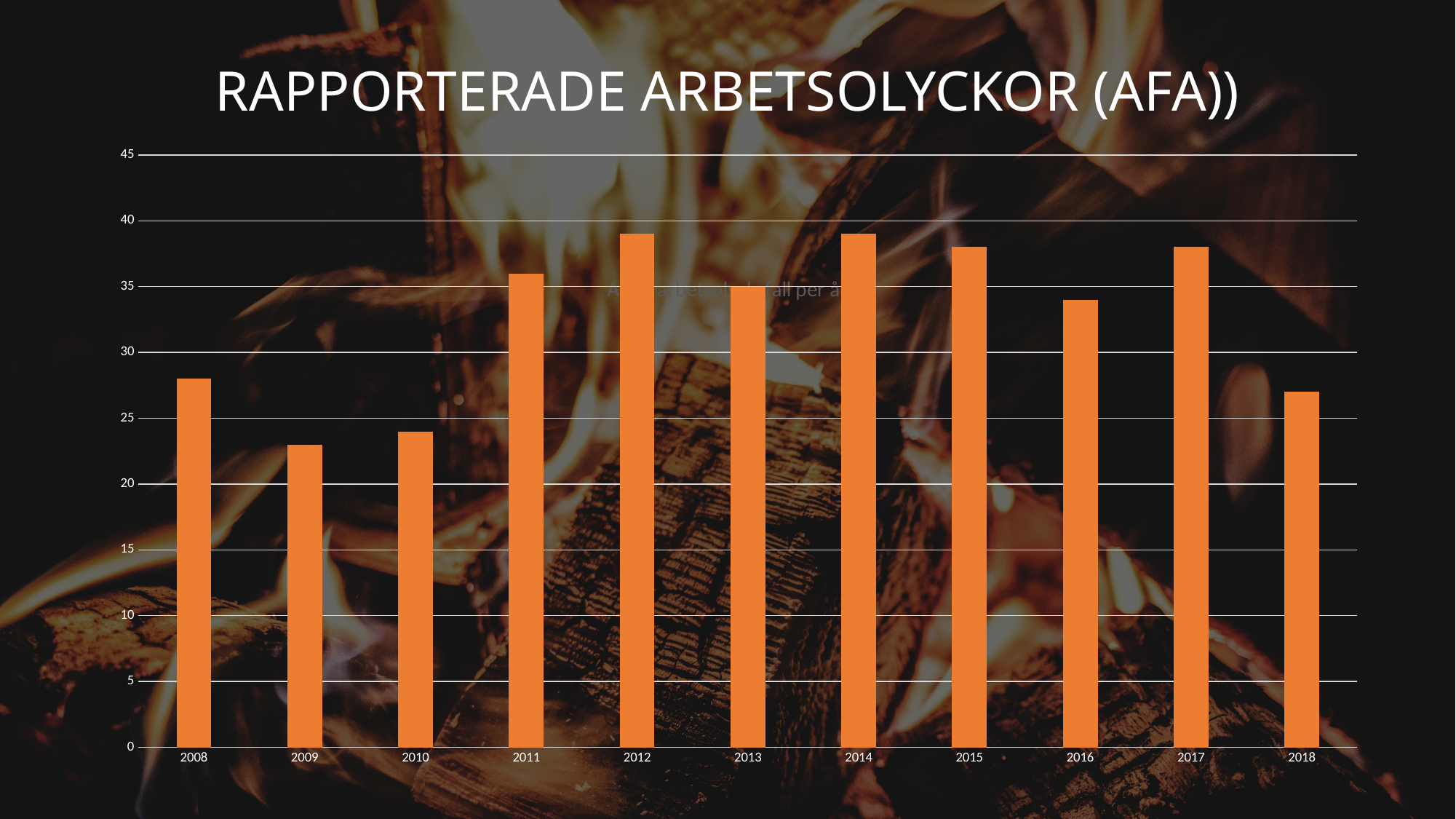
What is the title of the chart? RAPPORTERADE ARBETSOLYCKOR (AFA)) What kind of chart is shown on the slide? bar chart How many years are shown on the x axis of the chart? 11 Is the value for 2008 greater or less than 25? greater Which year has the larger value, 2008 or 2011? 2011 Is the value for 2009 greater or less than 25? less Is the value for 2018 greater or less than 30? less Do the values rise or fall from 2009 to 2012? rise Which year has the larger value, 2017 or 2018? 2017 Which year has the larger value, 2009 or 2012? 2012